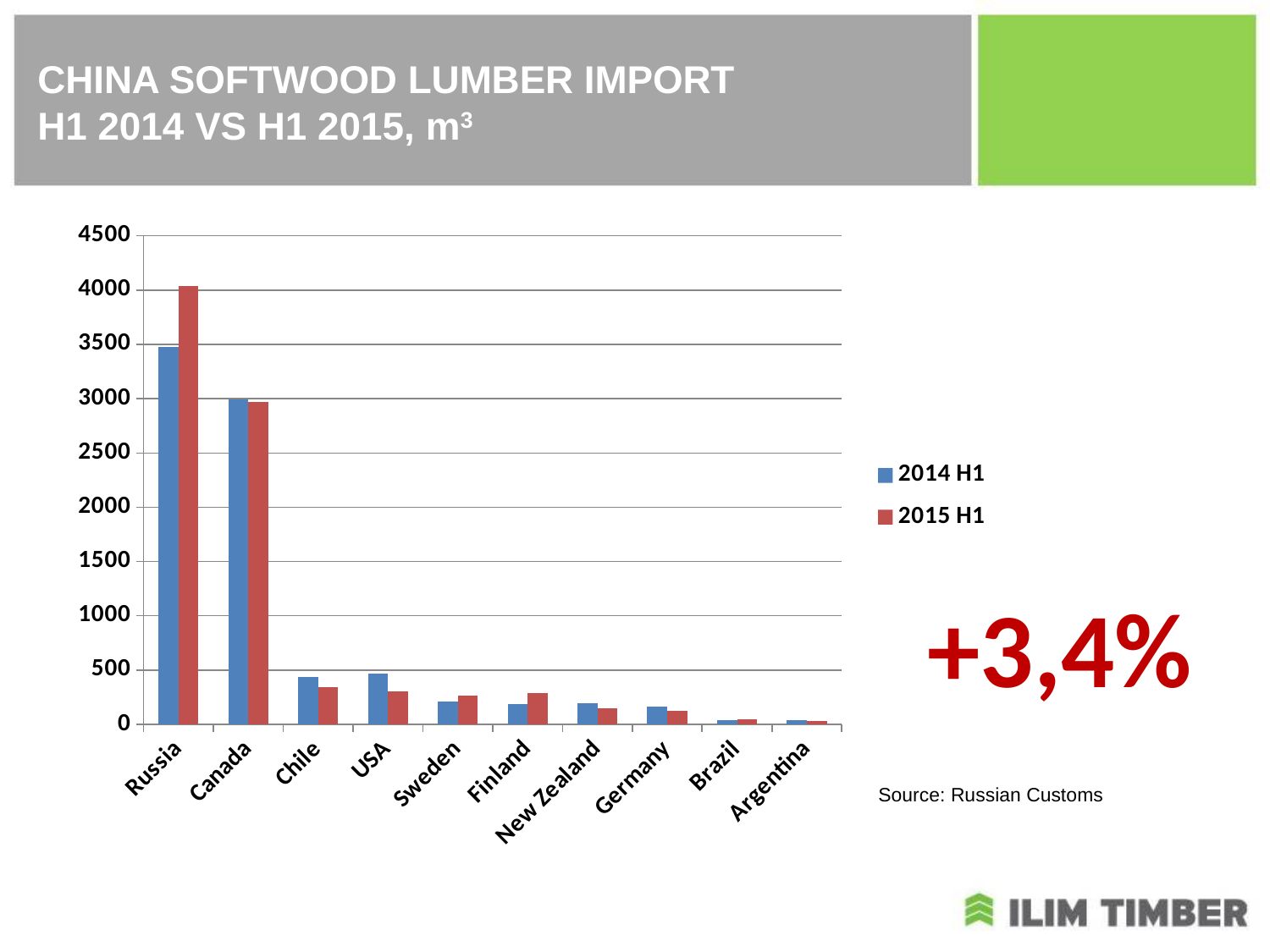
For Russia, which is larger: 2014 H1 or 2015 H1? 2015 H1 Is the 2014 H1 value for Russia greater or less than 3000? greater Is the 2014 H1 value for Canada greater or less than 2500? greater How many series does the legend list? 2 Is the 2014 H1 value for Chile greater or less than 500? less How many countries are shown on the x axis? 10 What are the two entries in the chart legend? 2014 H1 and 2015 H1 Which country has the highest 2015 H1 value? Russia For Finland, which is larger: 2014 H1 or 2015 H1? 2015 H1 What kind of chart is shown on the slide? bar chart For USA, which is larger: 2014 H1 or 2015 H1? 2014 H1